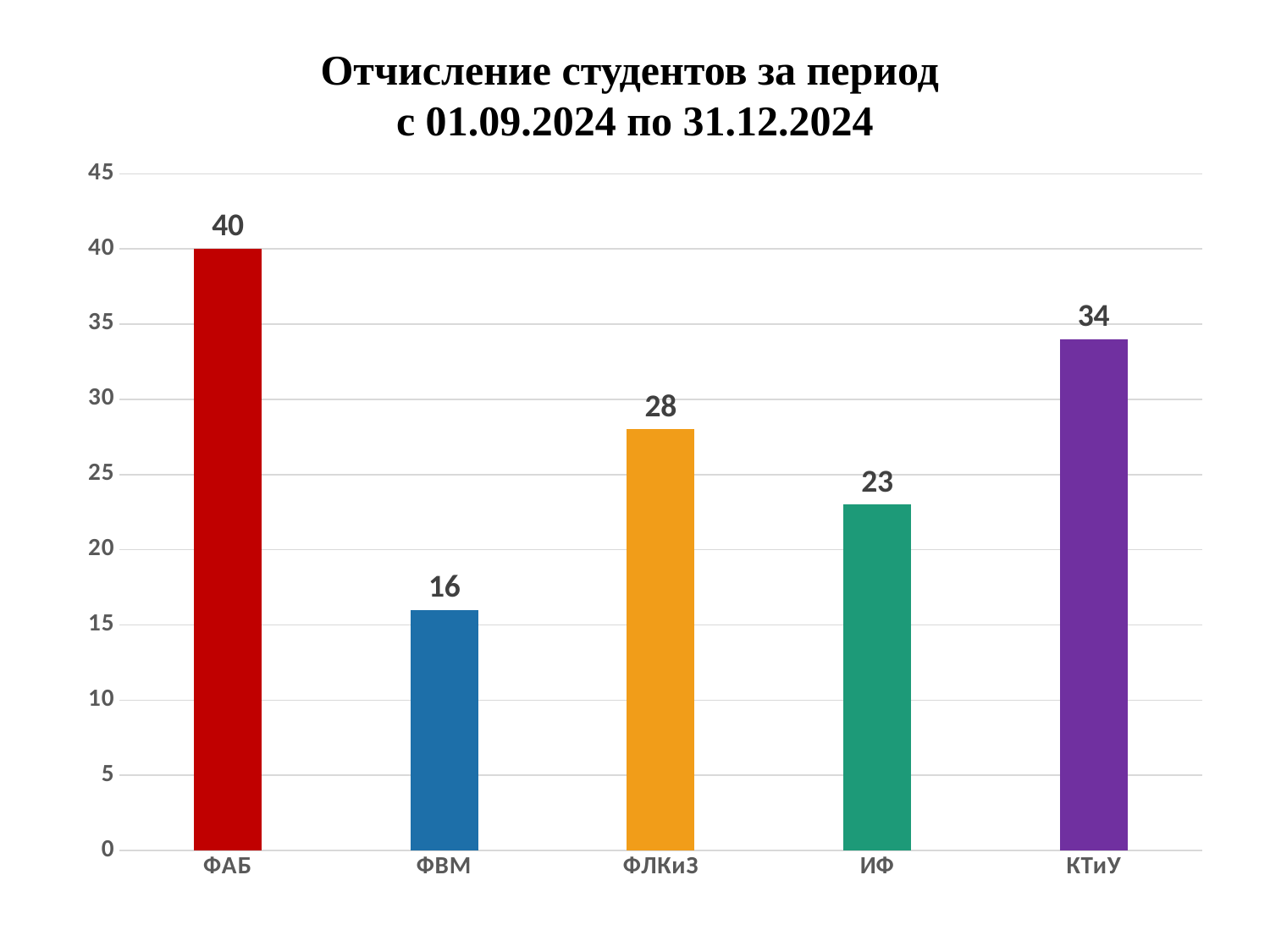
Which category has the lowest value? ФВМ What kind of chart is this? Bar chart What is the difference between the values for ФАБ and ФВМ? 24 How many categories are shown on the chart? 5 Which category has the highest value? ФАБ What is the value for ФАБ? 40 What is the value for ФВМ? 16 Which is larger, the value for ФЛКиЗ or the value for ИФ? ФЛКиЗ What is the value for ИФ? 23 What is the value for ФЛКиЗ? 28 What is the value for КТиУ? 34 What is the title of the chart? Отчисление студентов за период с 01.09.2024 по 31.12.2024